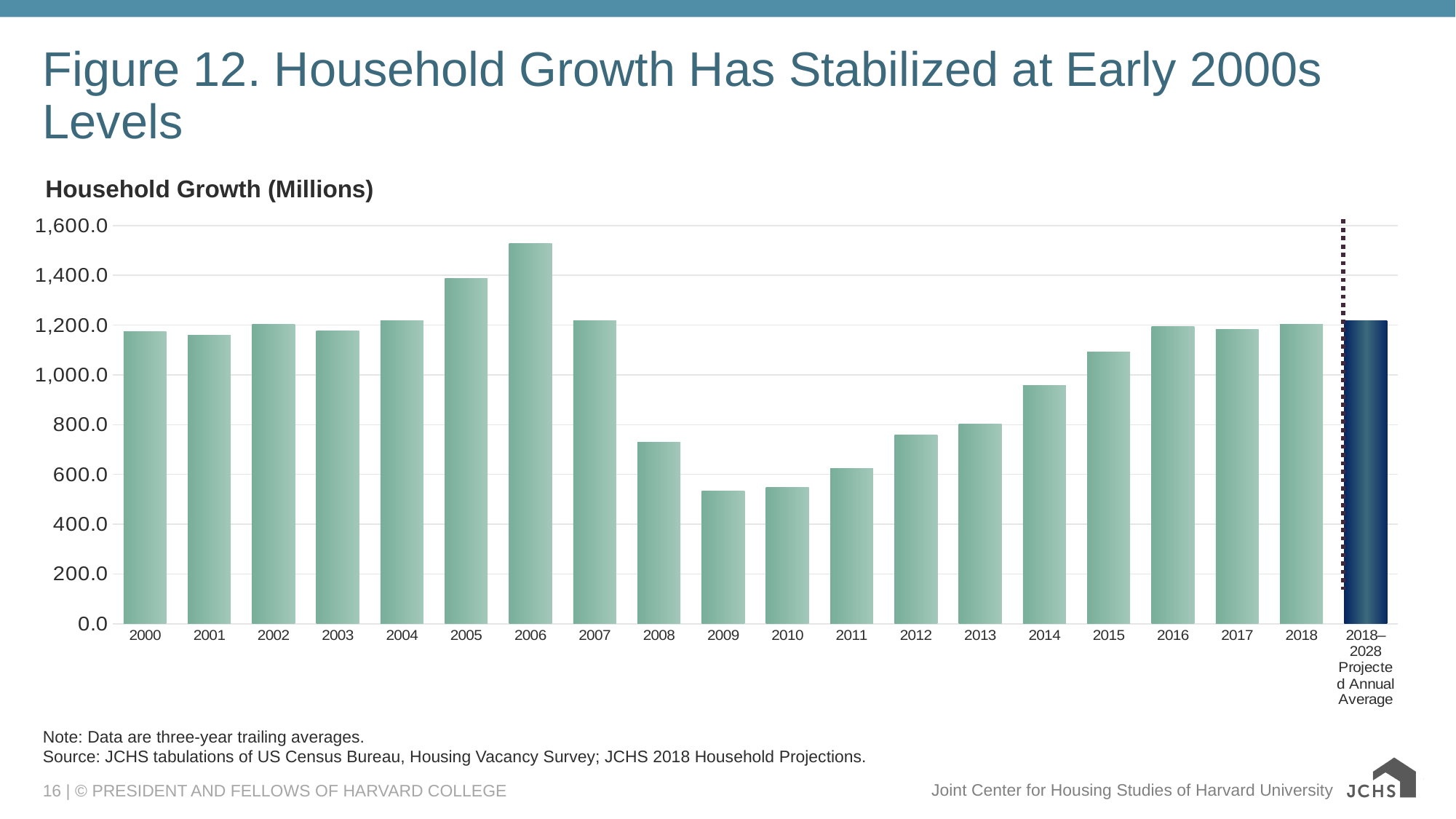
Is the value for 2015 greater or less than 1,000.0? greater Which is larger, the value for 2008 or the value for 2014? 2014 How many bars are plotted in the chart? 20 Is the value for 2008 greater or less than 800.0? less Which is larger, the value for 2005 or the value for 2006? 2006 Is the value for 2009 greater or less than 600.0? less Which year has the highest household growth? 2006 Do the values rise or fall from 2009 to 2018? Rise What kind of chart is shown on the slide? Bar chart What is the axis title shown above the chart? Household Growth (Millions)